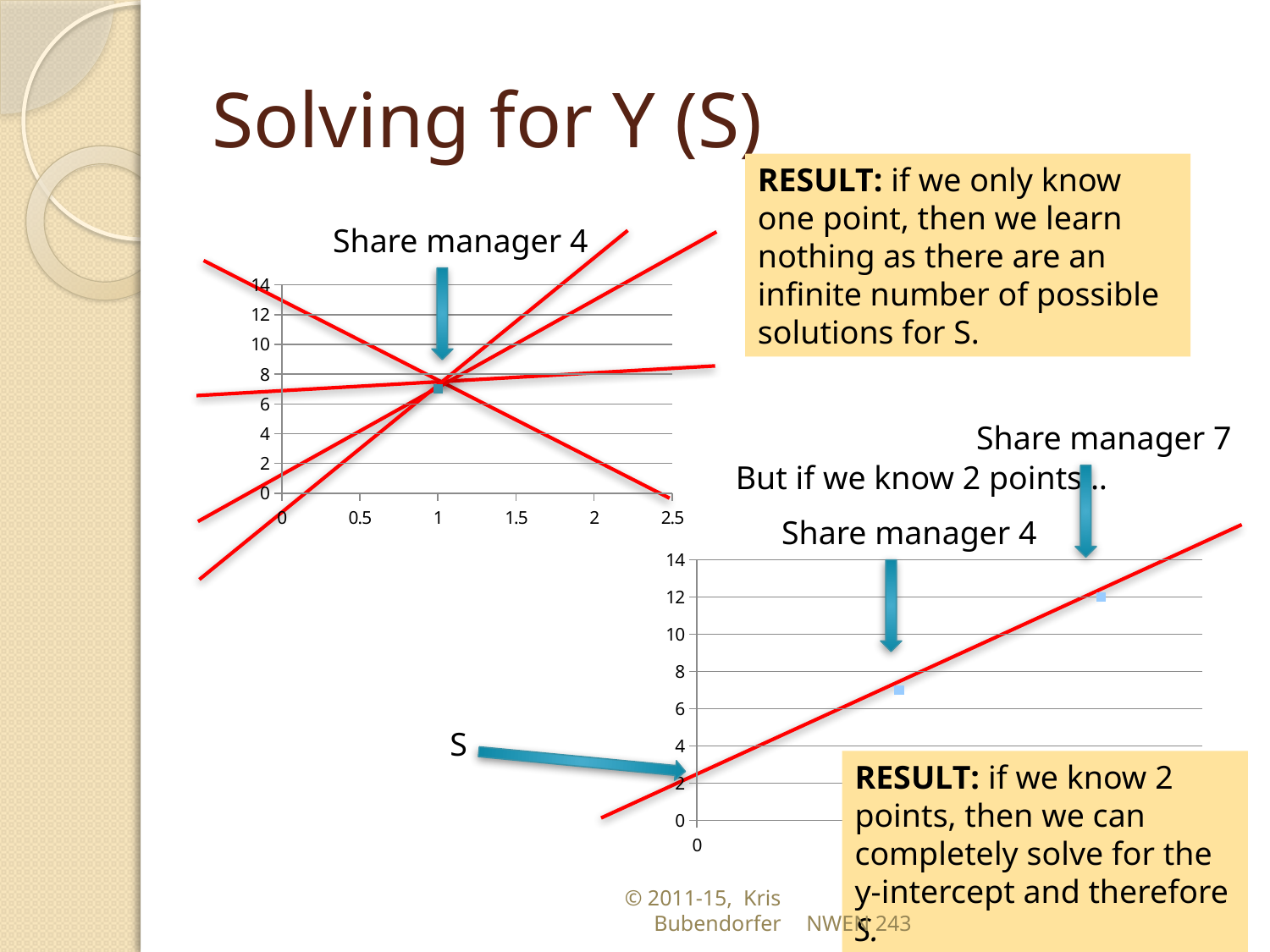
In the top-left chart, how many data points are plotted? 1 In the top-left chart, what is the highest value shown on the y axis? 14 In the bottom-right chart, is the value for Share manager 4 greater or less than 8? less In the top-left chart, what is the highest value shown on the x axis? 2.5 In the bottom-right chart, does the red line rise or fall as x increases? rises In the bottom-right chart, is the value for Share manager 7 greater or less than 10? greater In the bottom-right chart, how many data points are plotted? 2 In the top-left chart, is the value for Share manager 4 greater or less than 8? less What kind of chart is the bottom-right chart? scatter chart In the bottom-right chart, which point is higher, Share manager 4 or Share manager 7? Share manager 7